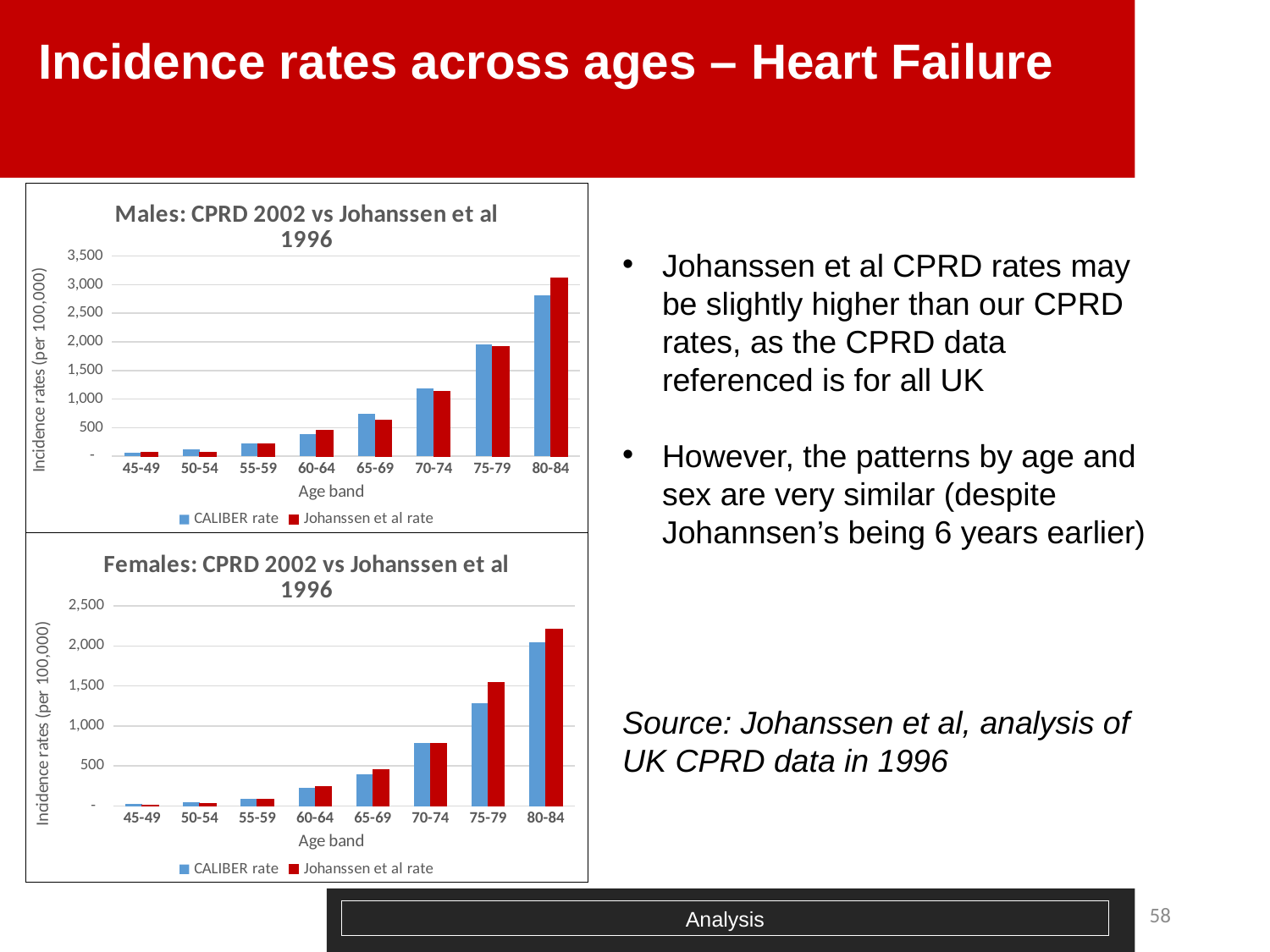
In the Males chart, what kind of chart is shown? bar chart In the Males chart, is the CALIBER rate for 80-84 greater or less than 2,500? greater In the Males chart, what is the label of the y axis? Incidence rates (per 100,000) In the Males chart, do the CALIBER rates rise or fall as age band increases? rise In the Females chart, for the 75-79 age band, which series has the larger value: CALIBER rate or Johanssen et al rate? Johanssen et al rate In the Males chart, which age band has the highest CALIBER rate? 80-84 In the Females chart, how many series does the legend list? 2 In the Females chart, is the CALIBER rate for 70-74 greater or less than 1,000? less In the Females chart, which age band has the lowest Johanssen et al rate? 45-49 In the Males chart, is the CALIBER rate for 70-74 greater or less than 1,000? greater In the Males chart, how many age bands are shown on the x axis? 8